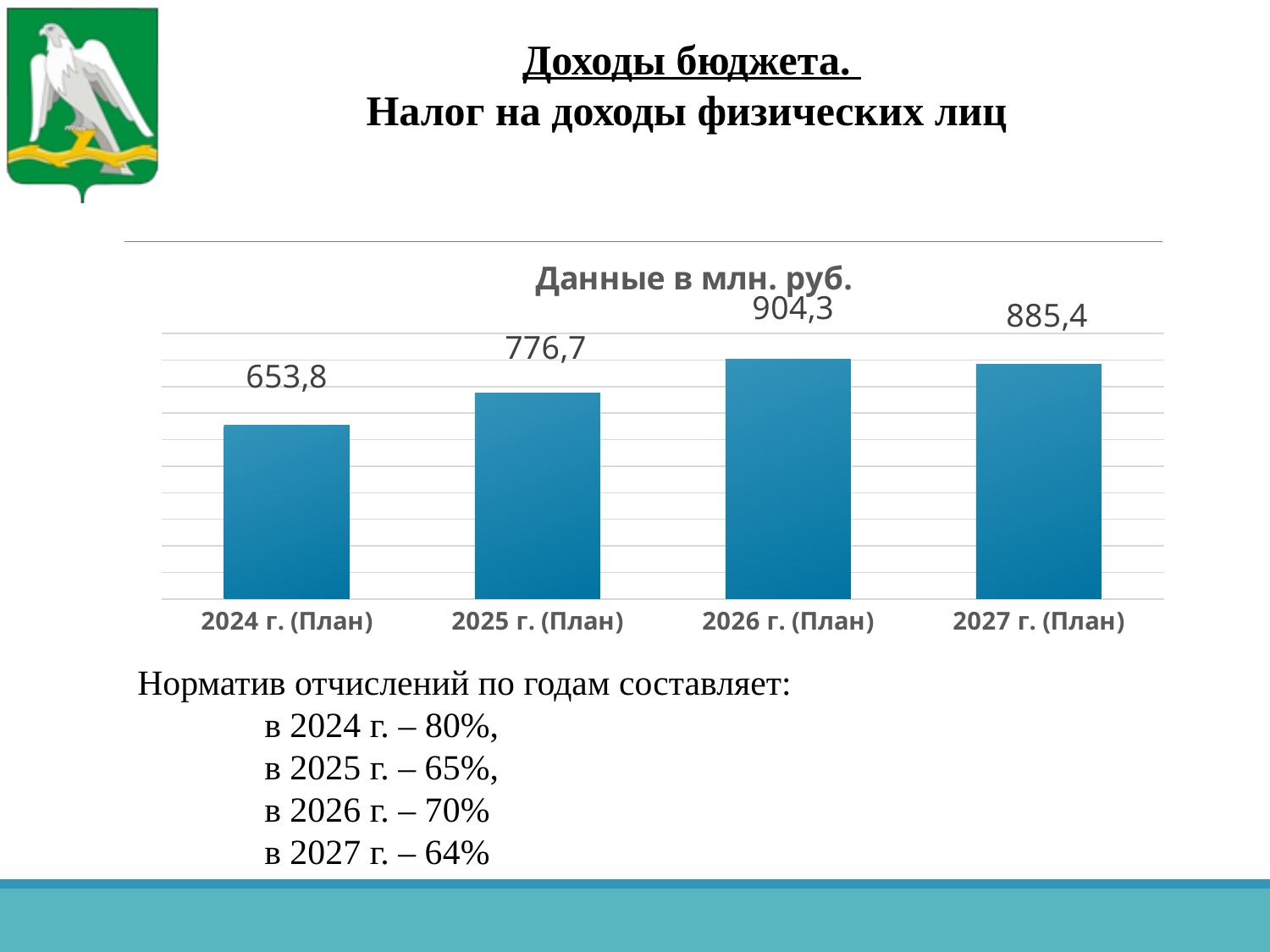
What is the value for 2027 г. (План)? 885,4 Which is larger, the value for 2026 г. (План) or 2027 г. (План)? 2026 г. (План) What is the value for 2026 г. (План)? 904,3 How many categories are shown in the chart? 4 What is the difference between the values for 2025 г. (План) and 2024 г. (План)? 122,9 What kind of chart is shown on the slide? Bar chart What is the value for 2025 г. (План)? 776,7 What is the difference between the values for 2026 г. (План) and 2027 г. (План)? 18,9 Which year has the highest value? 2026 г. (План) What is the value for 2024 г. (План)? 653,8 Do the values rise or fall from 2024 г. (План) to 2026 г. (План)? Rise Which year has the lowest value? 2024 г. (План)